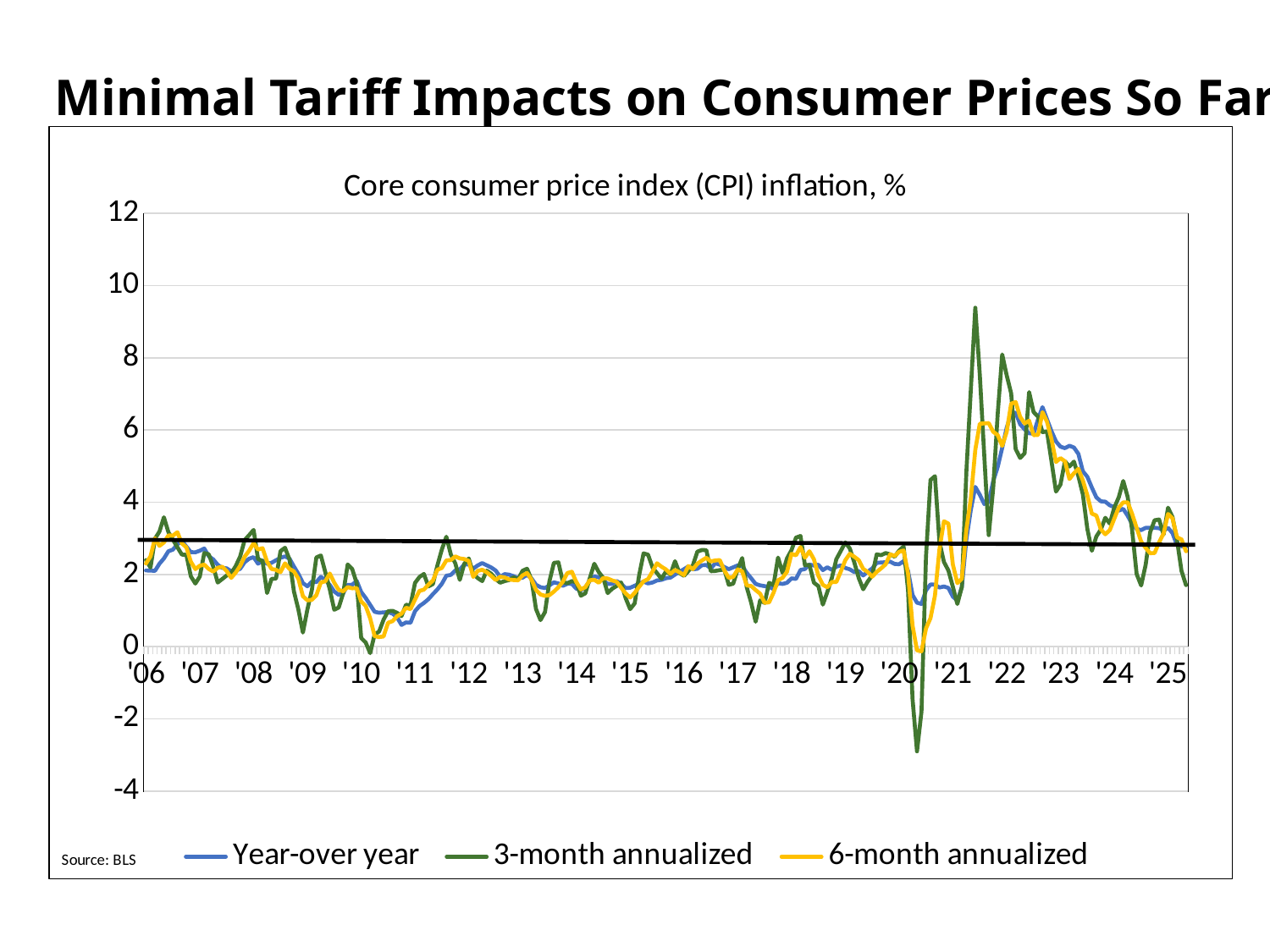
Is the peak of the 3-month annualized series around '21 greater or less than 8? greater Which series reaches the lowest value on the chart? 3-month annualized What is the title of the chart? Core consumer price index (CPI) inflation, % How many year labels are shown on the x axis? 20 Which series is drawn in yellow? 6-month annualized Is the lowest point of the 3-month annualized series around '20 greater or less than -2? less Between '22 and '24, does the Year-over year line rise or fall? Fall At the peak around '21, which is higher: the 3-month annualized series or the 6-month annualized series? 3-month annualized Which series reaches the highest value on the chart? 3-month annualized How many series does the legend list? 3 Is the peak of the Year-over year series around '22 greater or less than 8? less What kind of chart is shown on the slide? Line chart